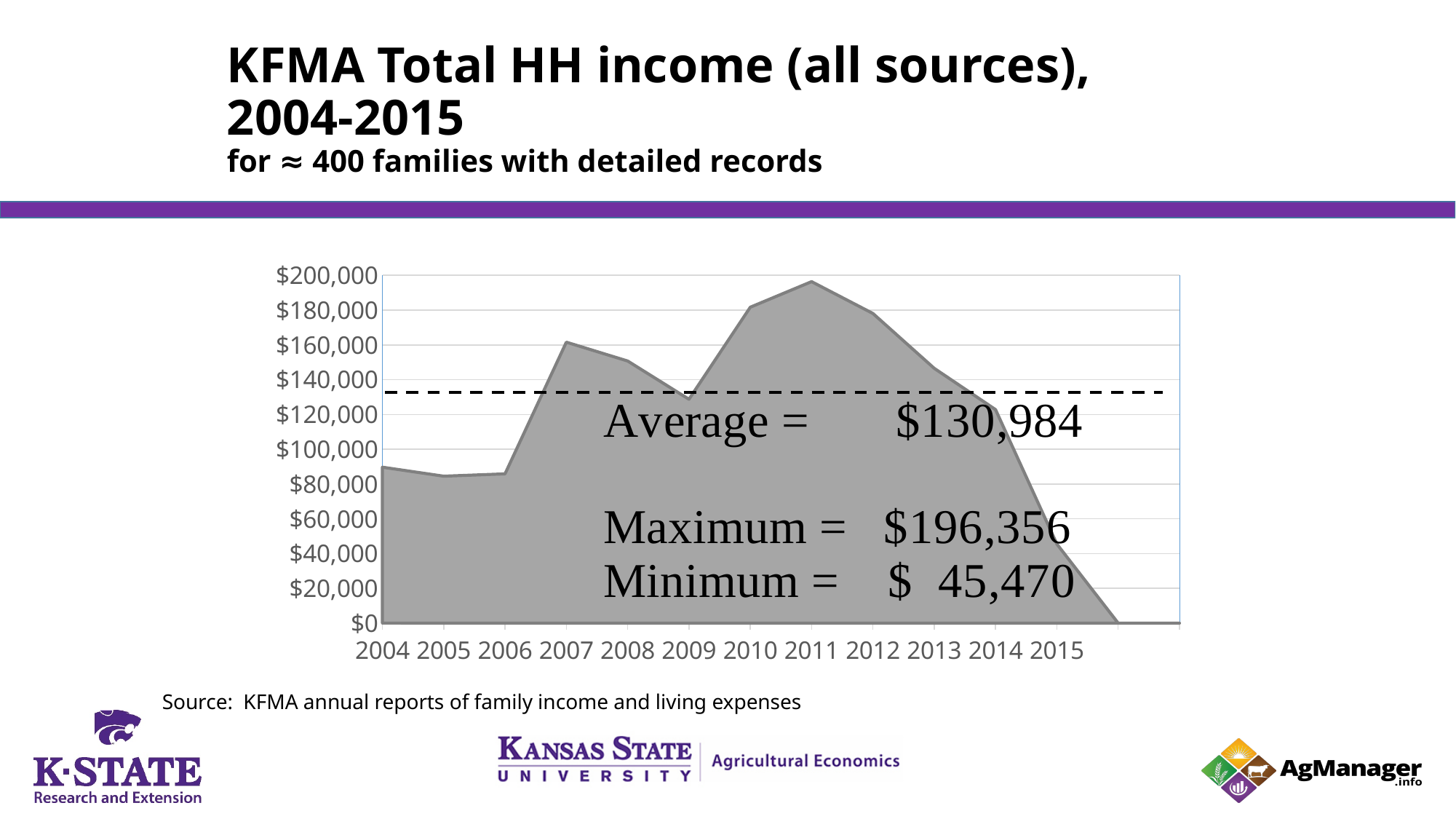
How many years are labeled on the x axis? 12 Do the values rise or fall from 2011 to 2015? fall Among the labeled years, which year has the lowest total household income? 2015 Is the value for 2004 greater or less than $100,000? less What is the Maximum value printed on the chart? $196,356 What kind of chart is shown on the slide? area chart Which year has a higher value, 2010 or 2011? 2011 What is the Average value printed on the chart? $130,984 Which year has the highest total household income? 2011 Is the value for 2007 greater or less than $140,000? greater What is the Minimum value printed on the chart? $45,470